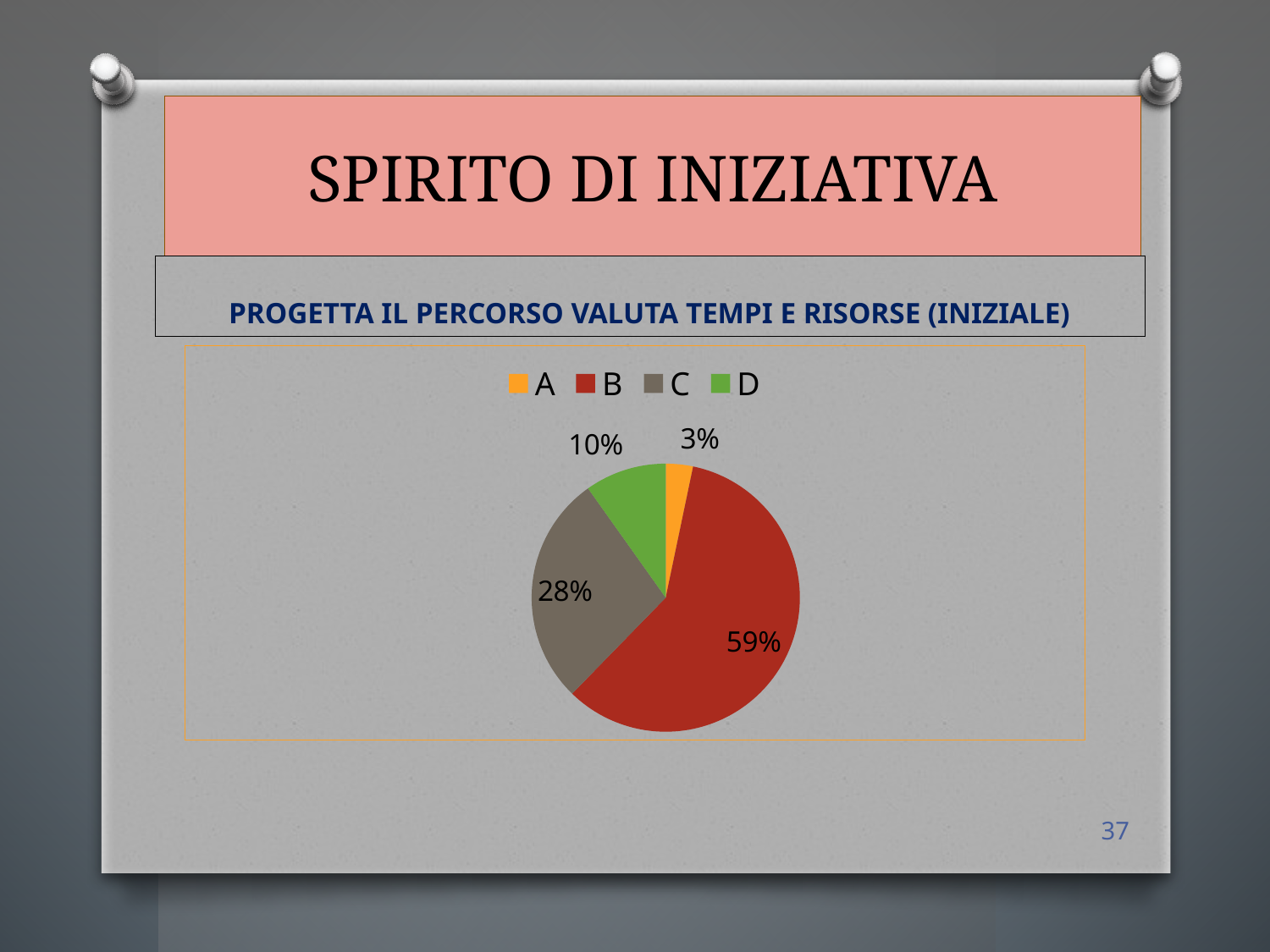
What percentage does slice C represent? 28% Which category has the smallest share of the pie? A Which category has the largest share of the pie? B What type of chart is shown on the slide? pie chart How many slices does the pie chart have? 4 What is the difference in percentage points between B and C? 31 What percentage does slice B represent? 59% What percentage does slice D represent? 10% What colour is the slice for category D? green How many categories does the legend list? 4 What percentage does slice A represent? 3% Which is larger, the share for C or the share for D? C